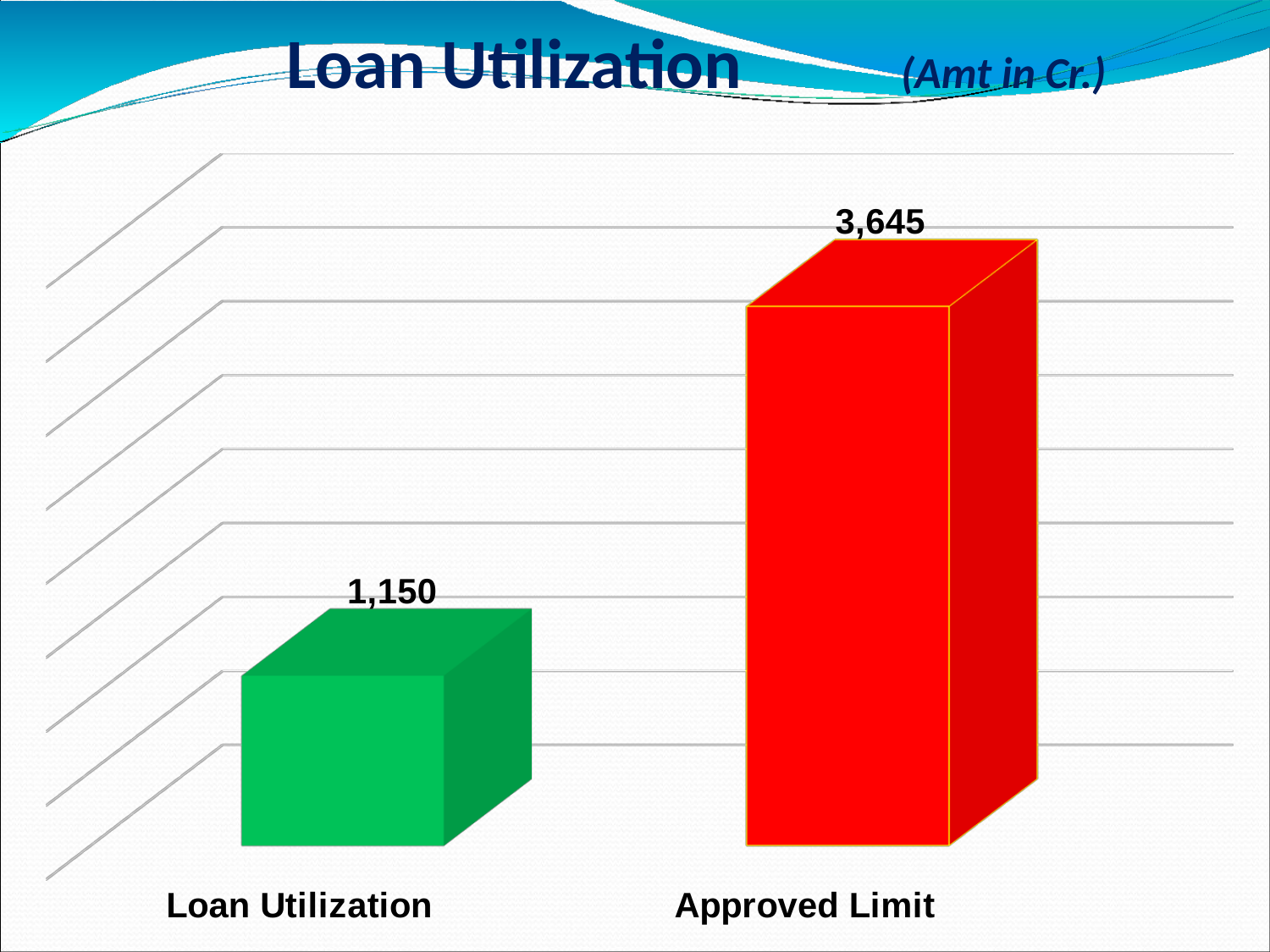
Which category has the highest value? Approved Limit Which category has the lowest value? Loan Utilization What is the value for Loan Utilization? 1,150 What colour is the Approved Limit bar? Red What is the difference between the Approved Limit and Loan Utilization values? 2,495 How many categories are shown in the chart? 2 What kind of chart is shown on the slide? Bar chart What is the title of the chart? Loan Utilization What is the value for Approved Limit? 3,645 In what unit are the amounts shown, according to the slide? Cr. Which is larger, Loan Utilization or Approved Limit? Approved Limit